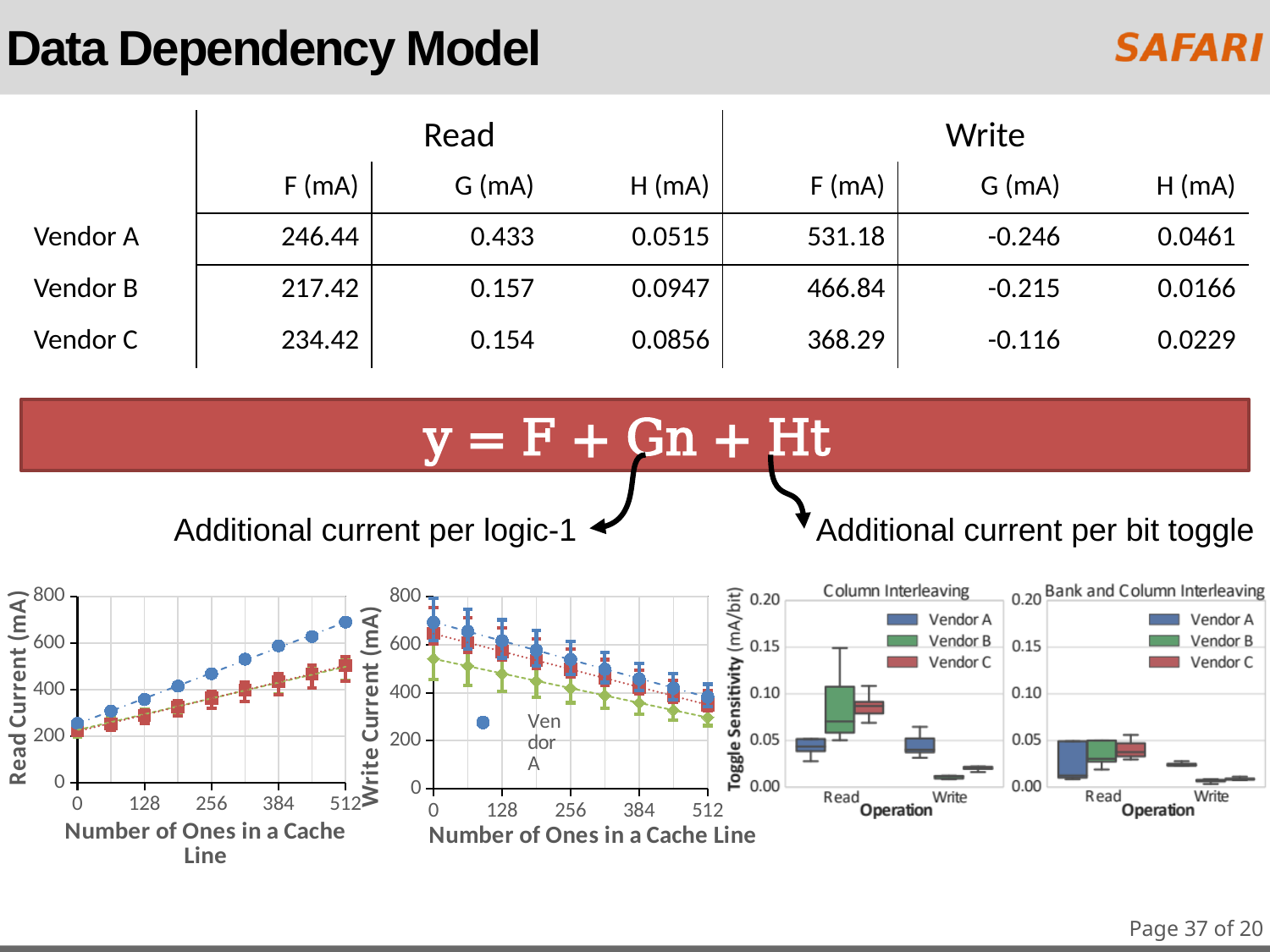
What is the y-axis label of the Column Interleaving and Bank and Column Interleaving charts? Toggle Sensitivity (mA/bit) How many operation categories are shown on the x axis of the Bank and Column Interleaving chart? 2 In the Read Current chart, is the value of the blue circle series at 512 ones greater or less than 600? greater In the Read Current chart, is the value of the red square series at 512 ones greater or less than 600? less In the Write Current chart, is the value of the green series at 512 ones greater or less than 400? less In the Read Current chart (bottom left), do the values rise or fall as the number of ones in a cache line increases? rise In the Write Current chart (bottom middle), do the values rise or fall as the number of ones in a cache line increases? fall How many series does the legend of the Column Interleaving chart list? 3 In the Column Interleaving chart, which vendor has the highest toggle sensitivity for the Read operation? Vendor B In the Read Current chart, which series is higher at 512 ones: the blue circles or the red squares? blue circles